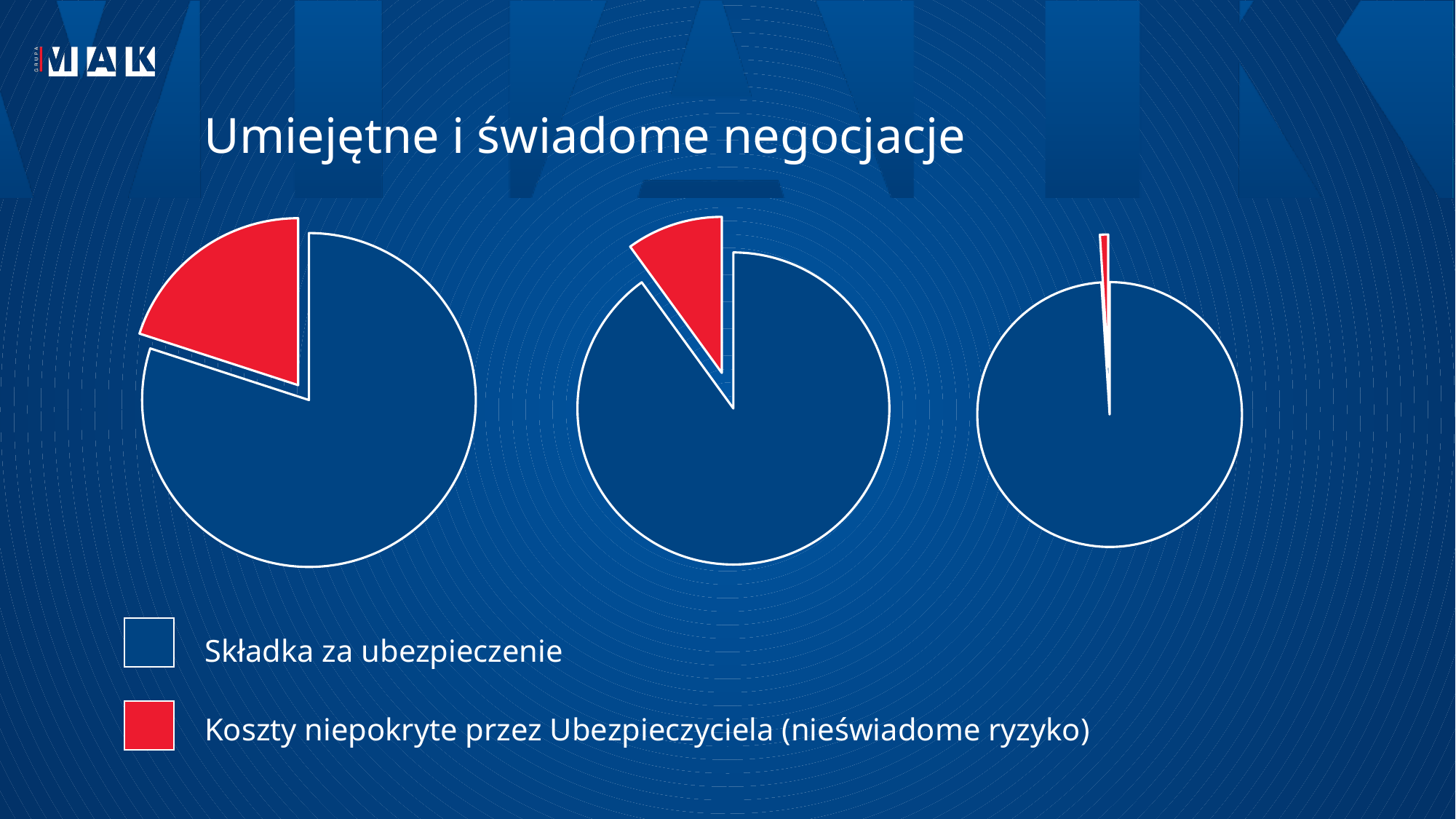
How many pie charts are on the slide? 3 What kind of chart is shown on the left of the slide? Pie chart Is the red slice in the left pie chart greater or less than 50% of the pie? less Which of the three pie charts has the smallest red slice for 'Koszty niepokryte przez Ubezpieczyciela (nieświadome ryzyko)'? The right pie chart How many slices does each pie chart have? 2 What colour represents 'Składka za ubezpieczenie' in the legend? Blue Which of the three pie charts has the largest red slice for 'Koszty niepokryte przez Ubezpieczyciela (nieświadome ryzyko)'? The left pie chart In the right pie chart, which category has the smallest slice? Koszty niepokryte przez Ubezpieczyciela (nieświadome ryzyko) In the middle pie chart, which category takes the largest share? Składka za ubezpieczenie How many entries does the legend list? 2 In the left pie chart, which category has the larger slice, 'Składka za ubezpieczenie' or 'Koszty niepokryte przez Ubezpieczyciela (nieświadome ryzyko)'? Składka za ubezpieczenie What is the title of the slide above the pie charts? Umiejętne i świadome negocjacje